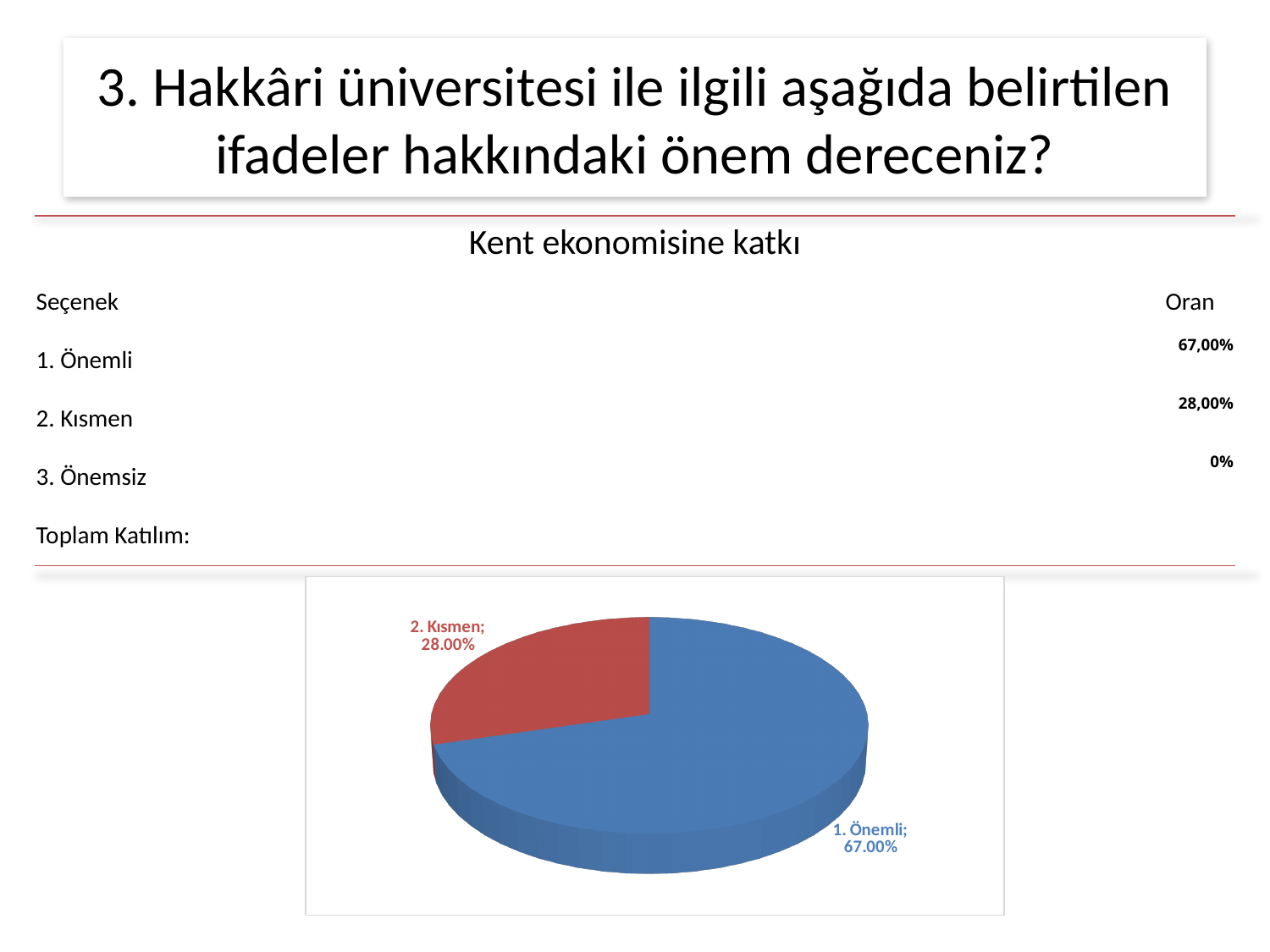
What kind of chart is shown on the slide? pie chart Is the value for "1. Önemli" in the pie chart greater or less than 50%? greater What is the difference between the "1. Önemli" and "2. Kısmen" values in the pie chart? 39.00% What is the value shown for the "2. Kısmen" slice of the pie chart? 28.00% Which slice of the pie chart is the largest? 1. Önemli What share of the pie does the "2. Kısmen" slice represent? 28.00% How many labelled slices does the pie chart have? 2 Which is larger in the pie chart, "1. Önemli" or "2. Kısmen"? 1. Önemli What colour is the "2. Kısmen" slice of the pie chart? red What is the value shown for the "1. Önemli" slice of the pie chart? 67.00% Which labelled slice of the pie chart is the smallest? 2. Kısmen What colour is the "1. Önemli" slice of the pie chart? blue